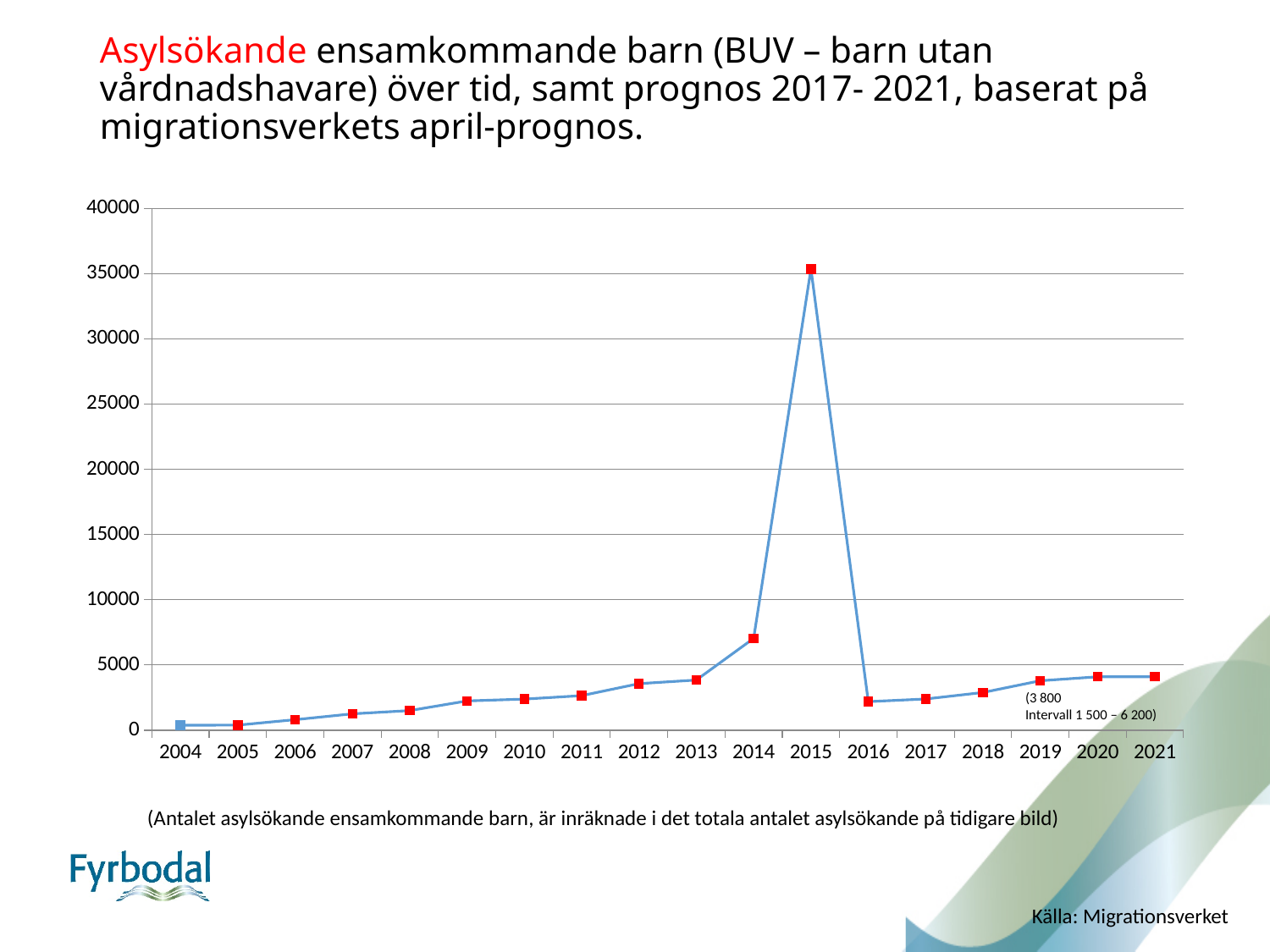
How many years are plotted along the x axis? 18 Is the value for 2014 greater or less than 5000? greater Is the value for 2010 greater or less than 5000? less Is the value for 2015 greater or less than 30000? greater Which year has the larger value, 2015 or 2016? 2015 What source is cited at the bottom right of the slide? Källa: Migrationsverket Which year has the highest value? 2015 Which year has the larger value, 2013 or 2014? 2014 Do the values rise or fall from 2004 to 2013? rise Do the values rise or fall from 2015 to 2016? fall What kind of chart is shown on the slide? line chart